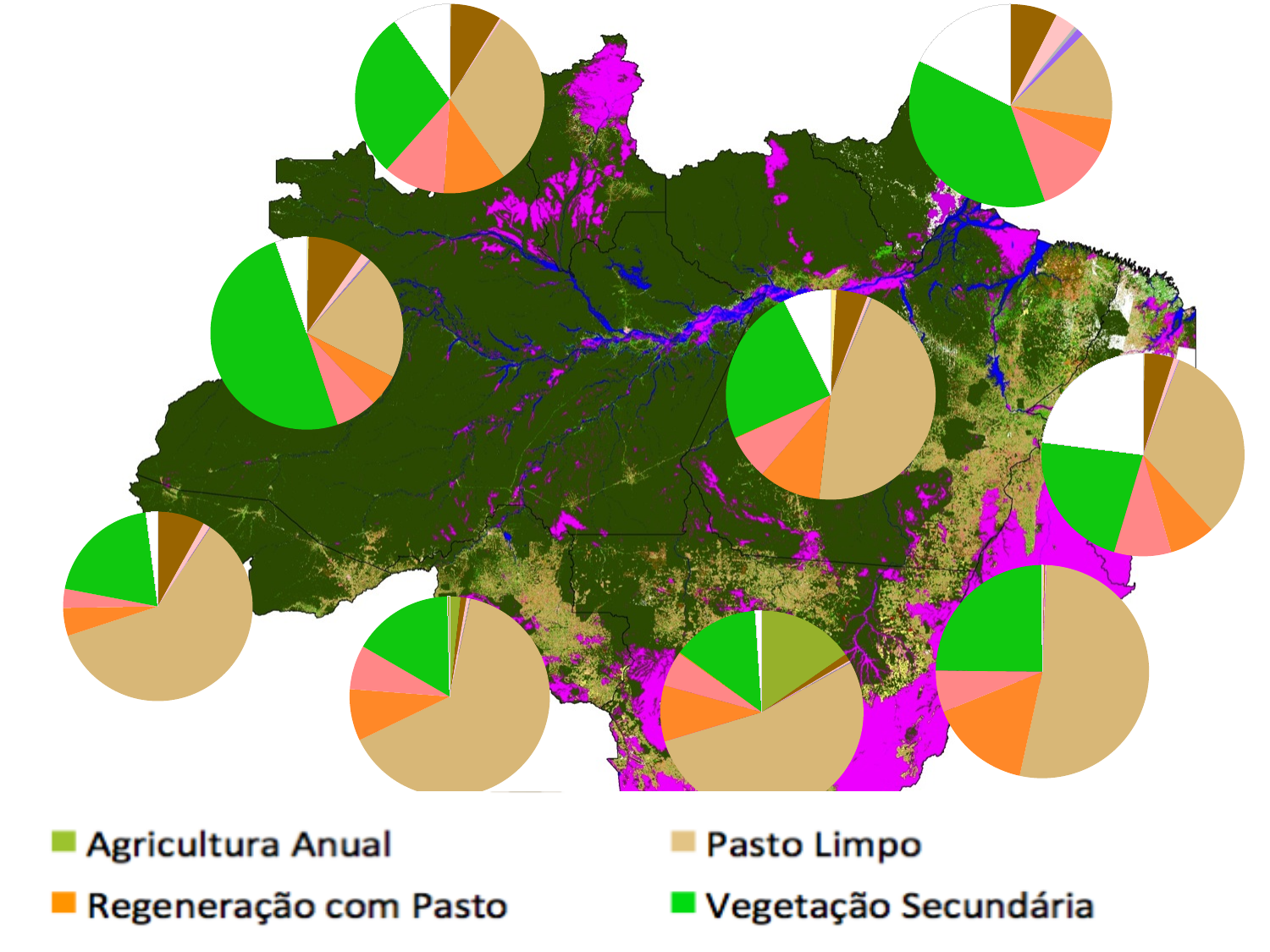
In the pie chart at the top right of the map, which legend category has the largest slice? Vegetação Secundária What kind of charts are overlaid on the map? Pie charts How many entries does the legend list? 4 Which legend category is shown in bright green? Vegetação Secundária In the pie chart on the left side of the map (middle row), which legend category has the largest slice? Vegetação Secundária In the pie chart on the left side of the map (middle row), which slice is larger: Vegetação Secundária or Regeneração com Pasto? Vegetação Secundária In the pie chart at the bottom right of the map, which legend category has the largest slice? Pasto Limpo How many pie charts are shown on the map? 9 In the pie chart at the bottom left of the map, which slice is larger: Pasto Limpo or Vegetação Secundária? Pasto Limpo Which colour does the legend use for Pasto Limpo? Tan